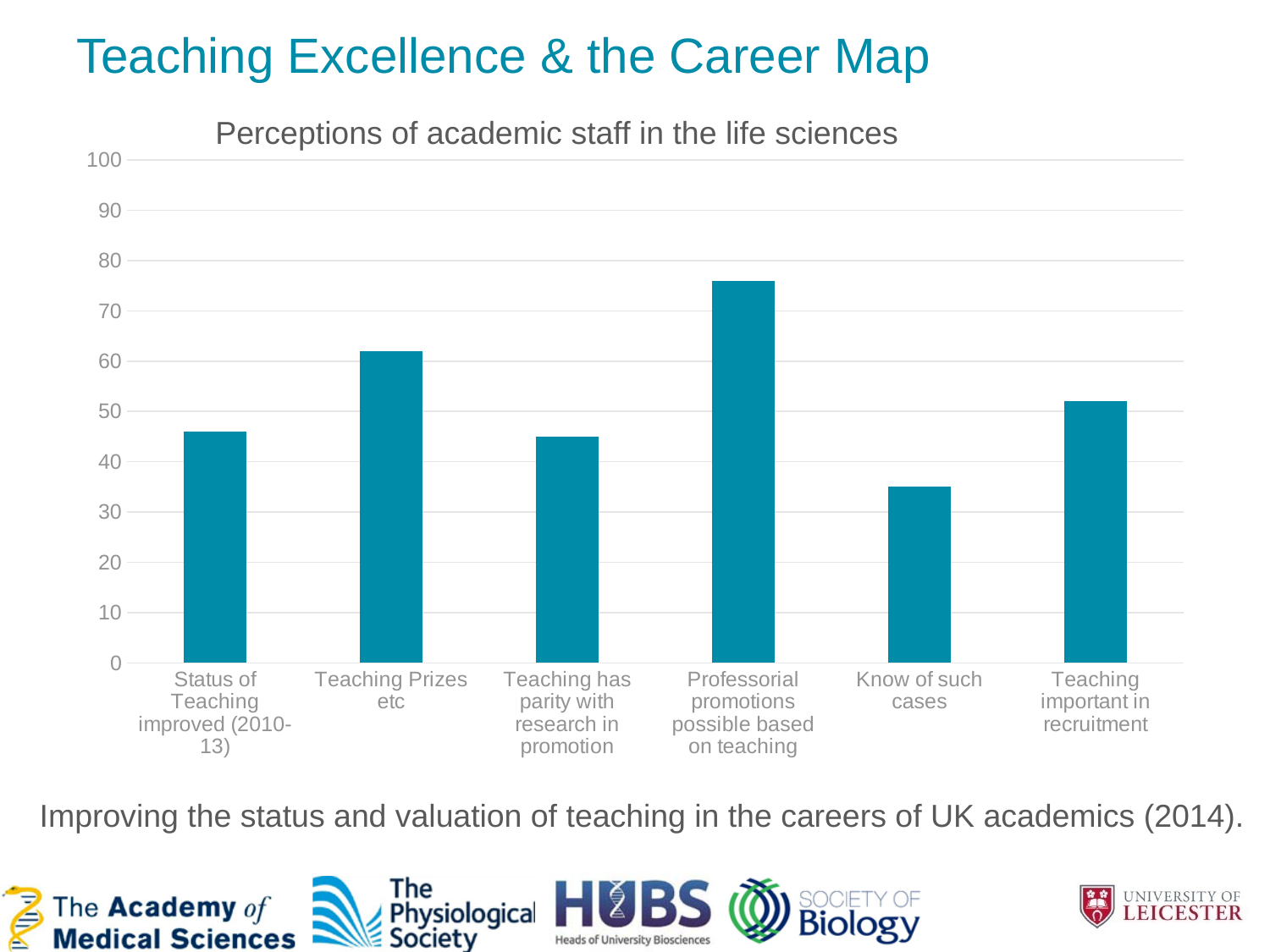
Is the value for Teaching Prizes etc greater or less than 50? greater Is the value for Professorial promotions possible based on teaching greater or less than 70? greater What type of chart is shown on the slide? bar chart Which category has the lowest value? Know of such cases Which category has the highest value? Professorial promotions possible based on teaching Is the value for Status of Teaching improved (2010-13) greater or less than 50? less Which is larger: the value for Professorial promotions possible based on teaching or the value for Know of such cases? Professorial promotions possible based on teaching What is the title of the chart? Perceptions of academic staff in the life sciences Which is larger: the value for Teaching Prizes etc or the value for Teaching important in recruitment? Teaching Prizes etc How many categories are plotted in the chart? 6